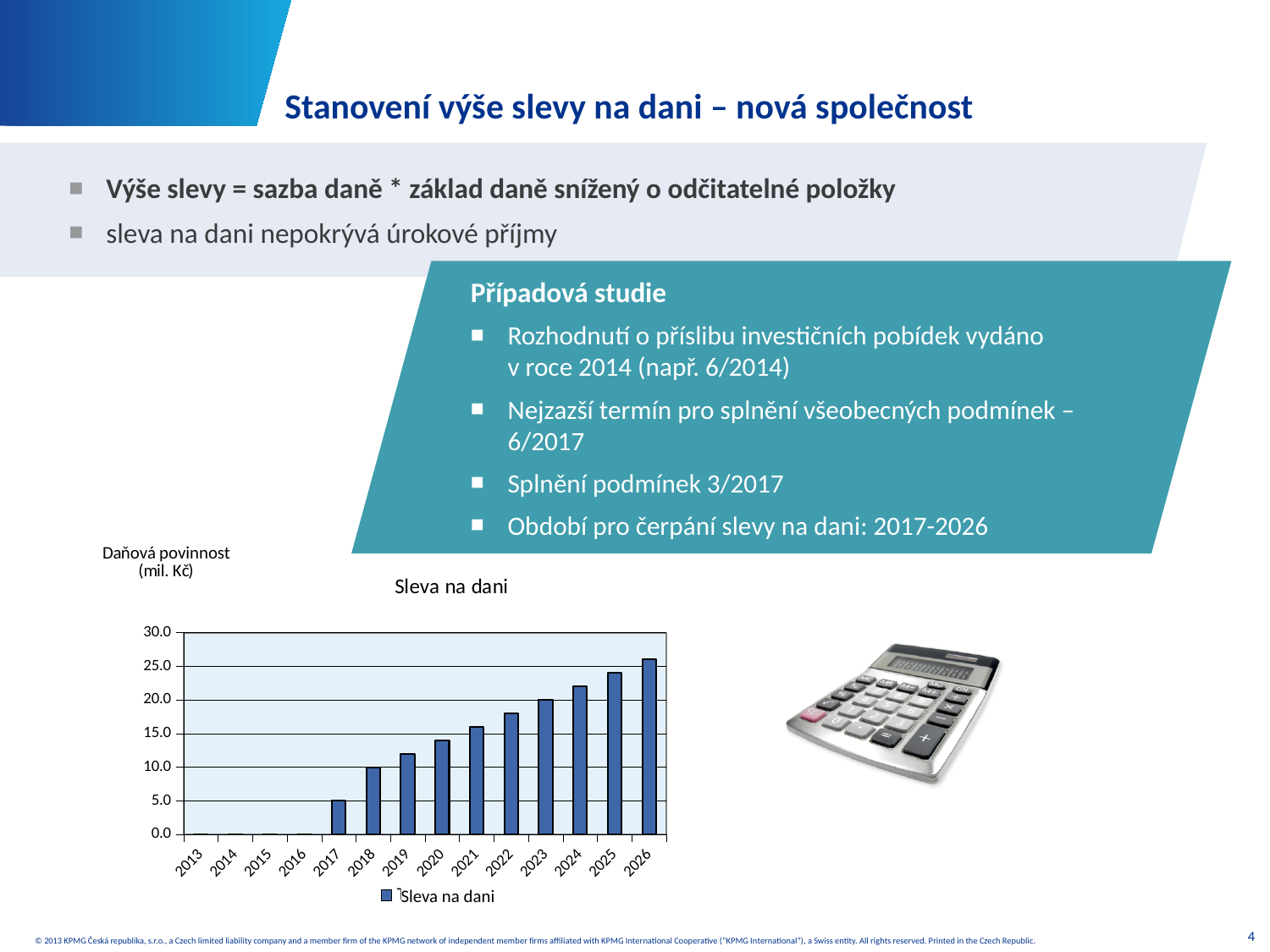
Is the value for 2026 greater or less than 25.0? greater What is the value for 2018 in the chart? 10.0 What is the difference between the values for 2023 and 2017? 15.0 How many years are shown on the x axis of the chart? 14 Do the values rise or fall from 2017 to 2026? rise What is the value for 2023 in the chart? 20.0 What kind of chart is shown on the slide? bar chart Is the value for 2020 greater or less than 15.0? less What is the value for 2017 in the chart? 5.0 Which year has the highest value in the chart? 2026 What is the label on the y axis of the chart? Daňová povinnost (mil. Kč) How many series does the chart's legend list? 1